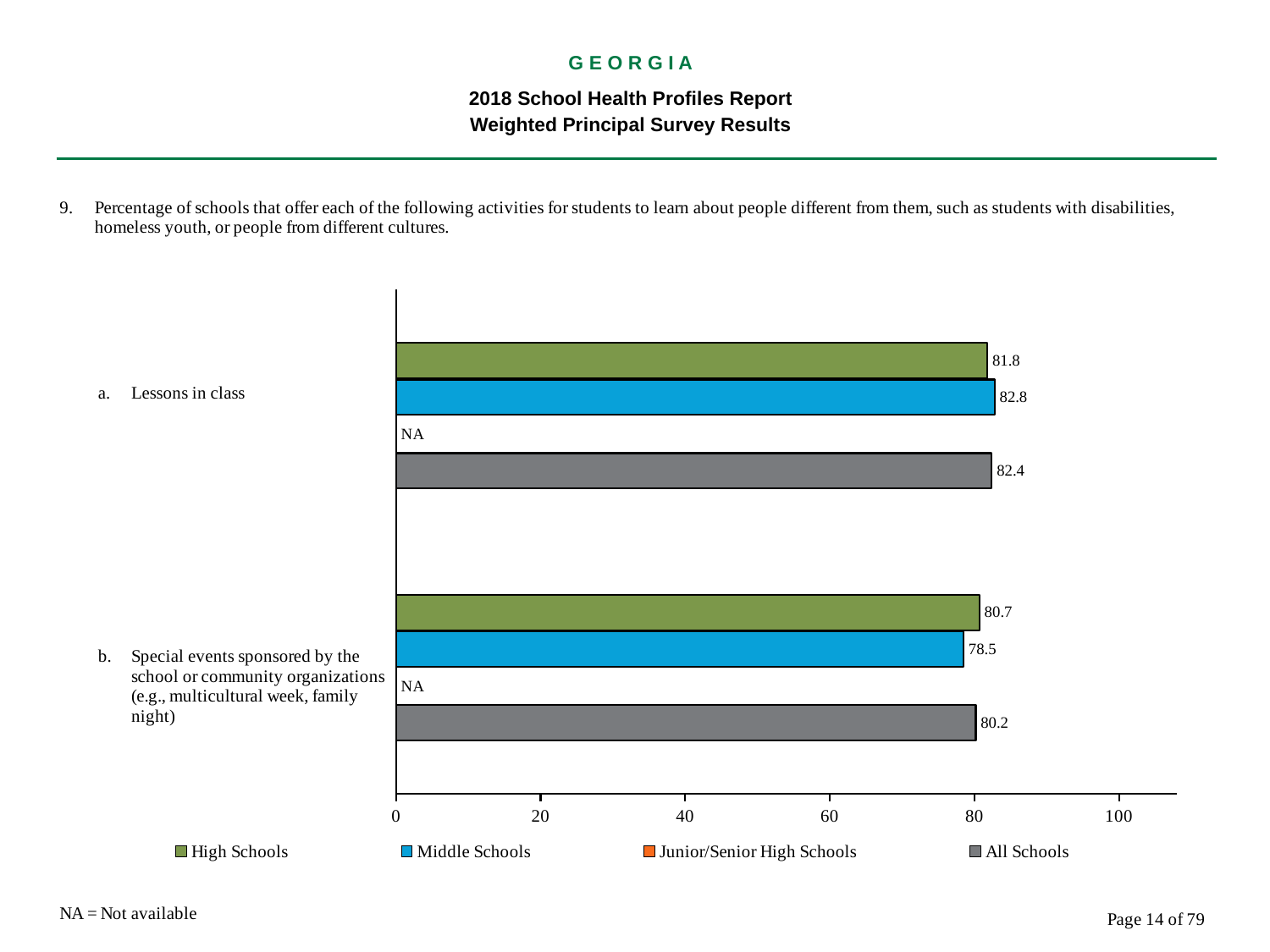
What kind of chart is shown on the slide? bar chart What colour represents All Schools in the legend? gray What is the difference between the High Schools and Middle Schools values for "Special events sponsored by the school or community organizations"? 2.2 What is the difference between the Middle Schools and High Schools values for "Lessons in class"? 1.0 How many series does the legend list? 4 What is the value for All Schools for "Special events sponsored by the school or community organizations"? 80.2 Is the Middle Schools value for "Special events sponsored by the school or community organizations" greater or less than 80? less Which is larger for "Special events sponsored by the school or community organizations": the High Schools value or the Middle Schools value? High Schools What is the value for Middle Schools for "Lessons in class"? 82.8 What is the value for High Schools for "Lessons in class"? 81.8 What value is shown for Junior/Senior High Schools for "Lessons in class"? NA What is the value for Middle Schools for "Special events sponsored by the school or community organizations"? 78.5